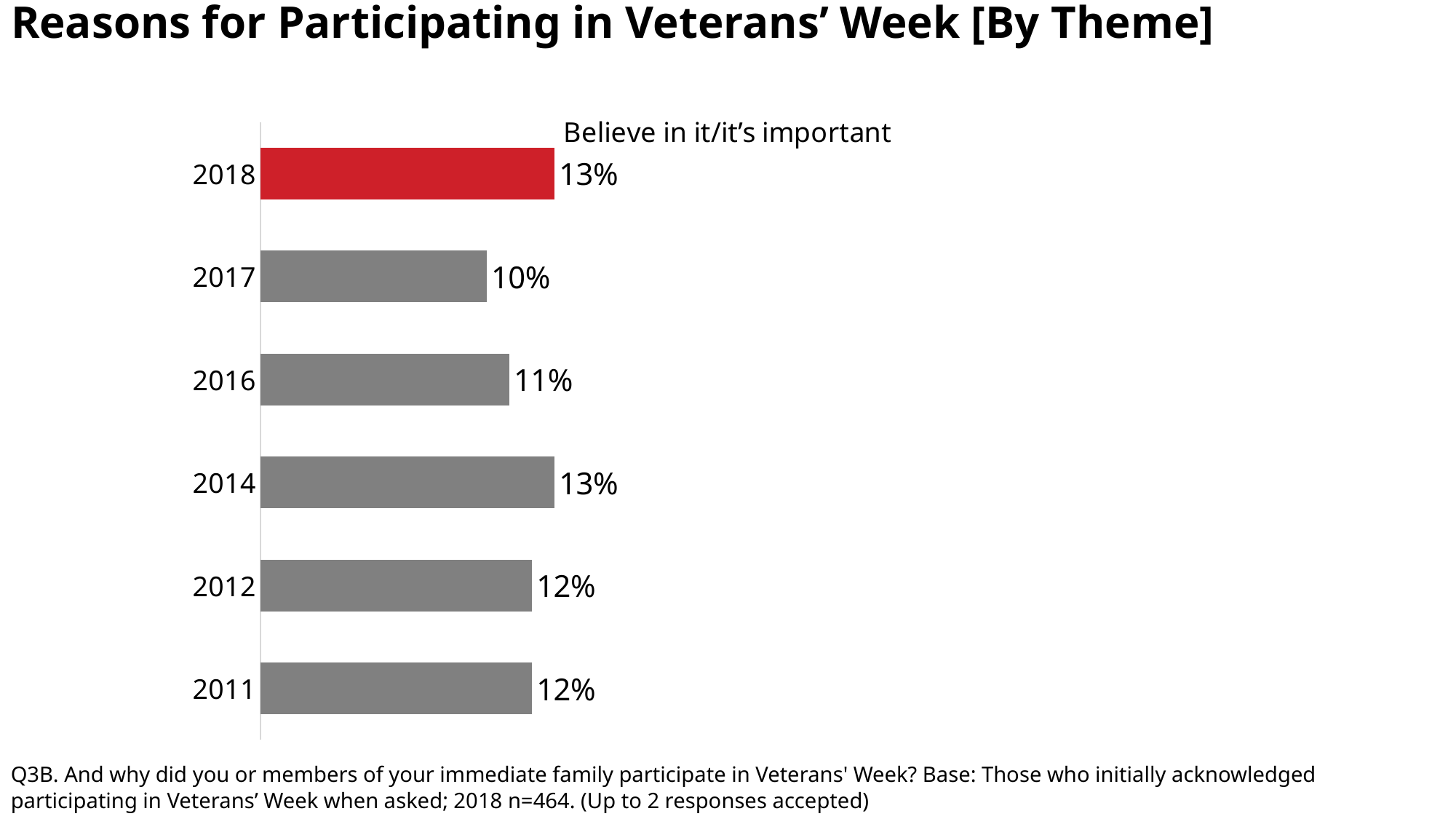
What is the value for 2017? 10% Which year has the lowest value? 2017 What is the value for 2016? 11% What is the difference between the values for 2018 and 2017? 3% What is the difference between the values for 2012 and 2016? 1% Which is larger, the value for 2014 or the value for 2016? 2014 What kind of chart is shown on the slide? Bar chart What is the value for 2018 in the 'Believe in it/it's important' chart? 13% What is the value for 2011? 12% How many years are shown in the chart? 6 Which year's bar is coloured red? 2018 What is the title of the slide? Reasons for Participating in Veterans' Week [By Theme]